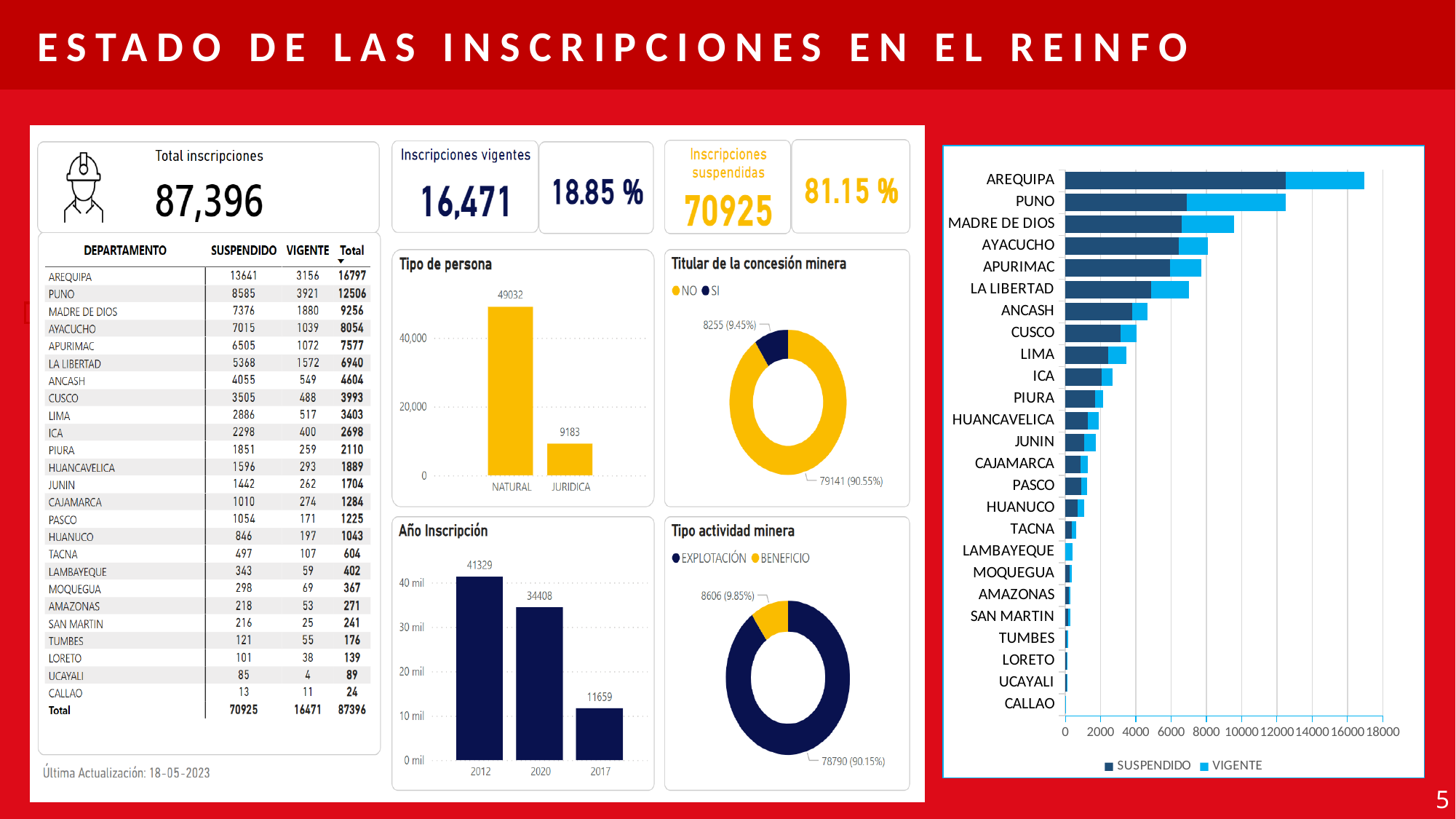
In the 'Año Inscripción' chart, which year has the lowest value? 2017 In the 'Tipo de persona' chart, what is the value for JURIDICA? 9183 How many departments are shown in the stacked bar chart on the right? 25 In the 'Titular de la concesión minera' donut chart, what share does the SI slice represent? 9.45% In the stacked bar chart on the right, is the total bar length for AREQUIPA greater or less than 16000? greater In the 'Tipo de persona' chart, what is the value for NATURAL? 49032 In the 'Año Inscripción' chart, what is the value for 2012? 41329 In the 'Tipo de persona' chart, what is the difference between the NATURAL and JURIDICA values? 39849 In the 'Tipo actividad minera' donut chart, what is the value for BENEFICIO? 8606 In the 'Año Inscripción' chart, what is the value for 2020? 34408 How many series does the legend of the stacked bar chart on the right list? 2 What kind of chart is the chart on the right side of the slide? Bar chart